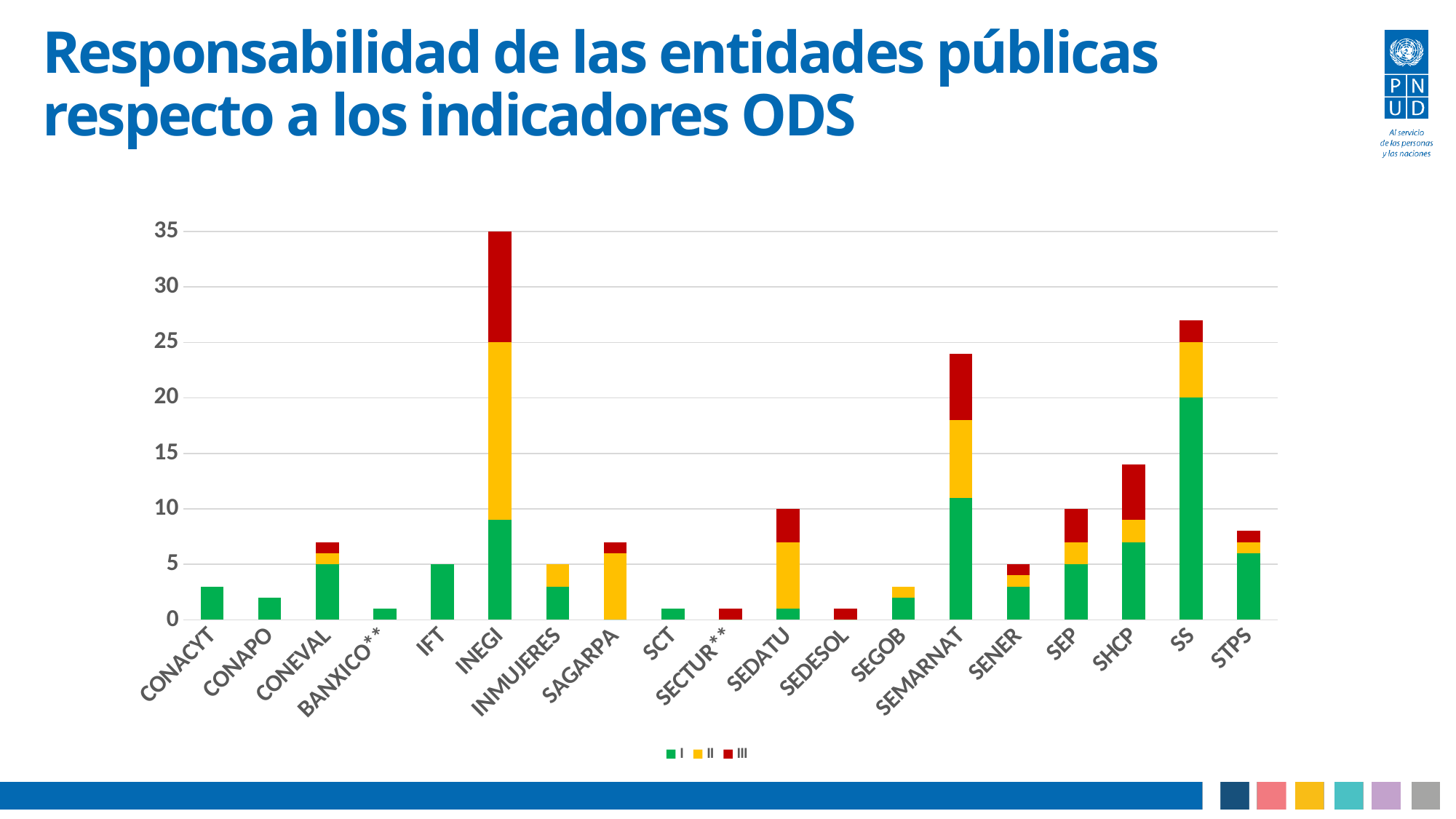
Which bar is taller, SS or SEMARNAT? SS What are the three legend entries? I, II, III How many series does the legend list? 3 What is the total height of the INEGI bar? 35 What is the value of the IFT bar? 5 What kind of chart is shown on the slide? Stacked bar chart How many entities (categories) are shown on the x axis? 19 Is the value for CONACYT greater or less than 5? less Which entity has the tallest bar? INEGI Is the total for SEMARNAT greater or less than 20? greater Is the total for SS greater or less than 25? greater What is the total height of the SEDATU bar? 10